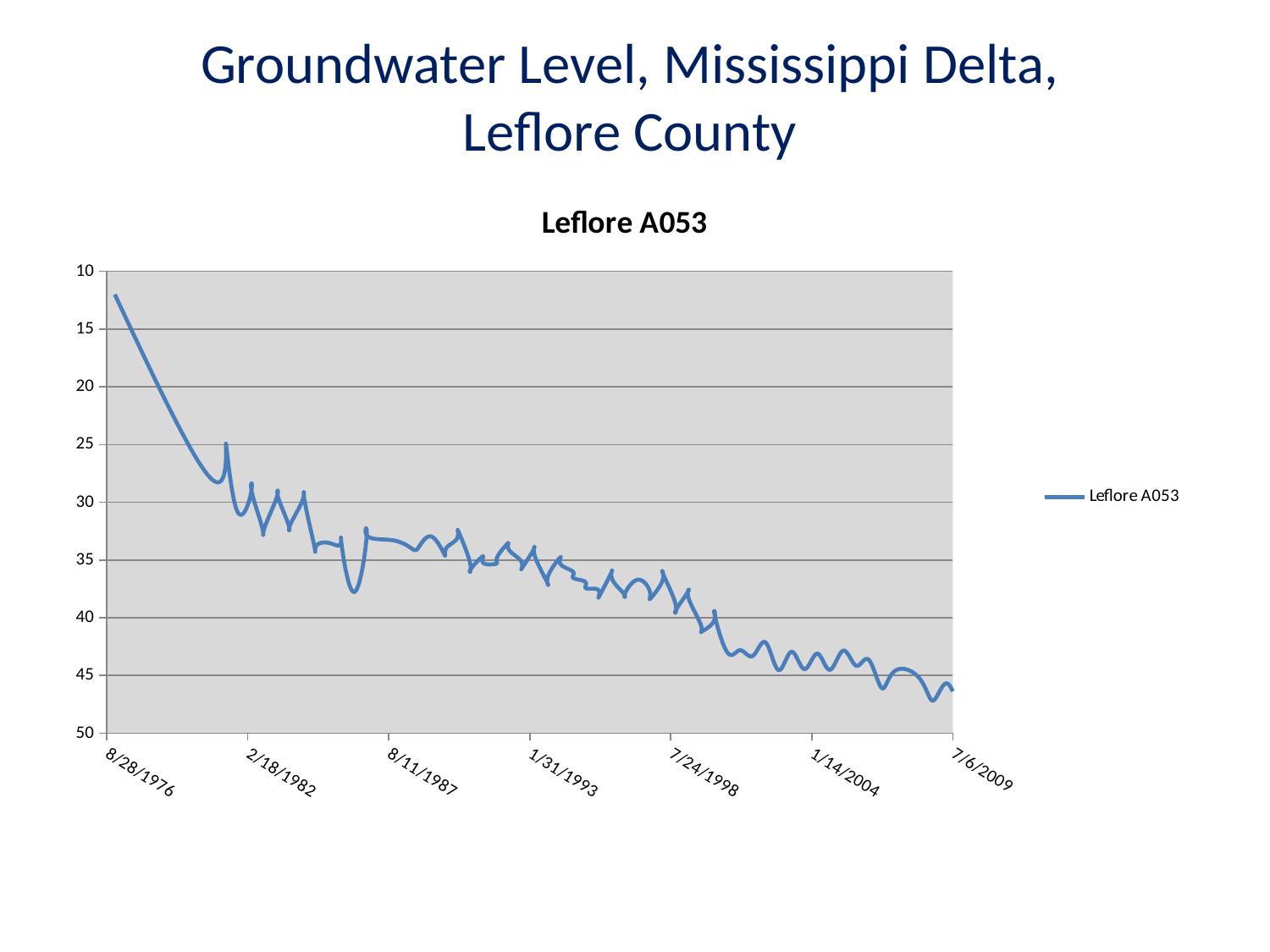
What is the title of the chart? Leflore A053 Is the value for 7/24/1998 greater or less than 45? less Do the plotted values numerically increase or decrease from 8/28/1976 to 7/6/2009? increase What value is shown at the top of the y axis? 10 Is the value for 8/11/1987 greater or less than 30? greater Is the value for 7/6/2009 greater or less than 45? greater What kind of chart is shown on the slide? line chart How many date labels are shown along the x axis? 7 How many series does the legend list? 1